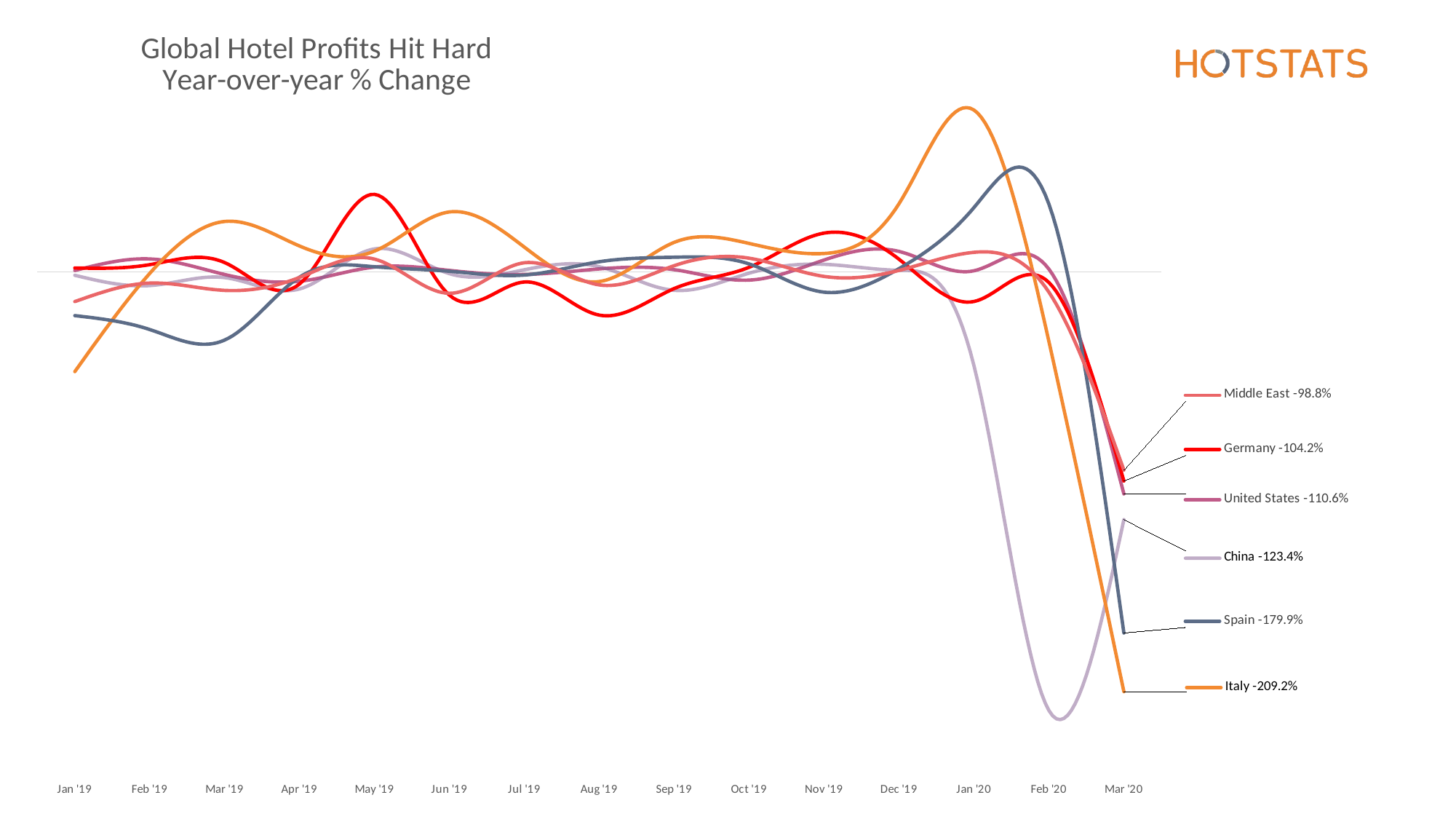
What is the year-over-year % change for China in Mar '20? -123.4% What is the year-over-year % change for the Middle East in Mar '20? -98.8% What is the year-over-year % change for Spain in Mar '20? -179.9% Which series has the lowest value in Mar '20? Italy What is the year-over-year % change for Italy in Mar '20? -209.2% What kind of chart is shown on the slide? Line chart Does the Italy line rise or fall between Jan '20 and Mar '20? Fall How many months are shown on the x axis? 15 Which series has the highest value in Mar '20? Middle East What is the difference between the Mar '20 values for Spain and Italy? 29.3 percentage points How many series are plotted on the chart? 6 In Mar '20, which is higher: Germany or the United States? Germany